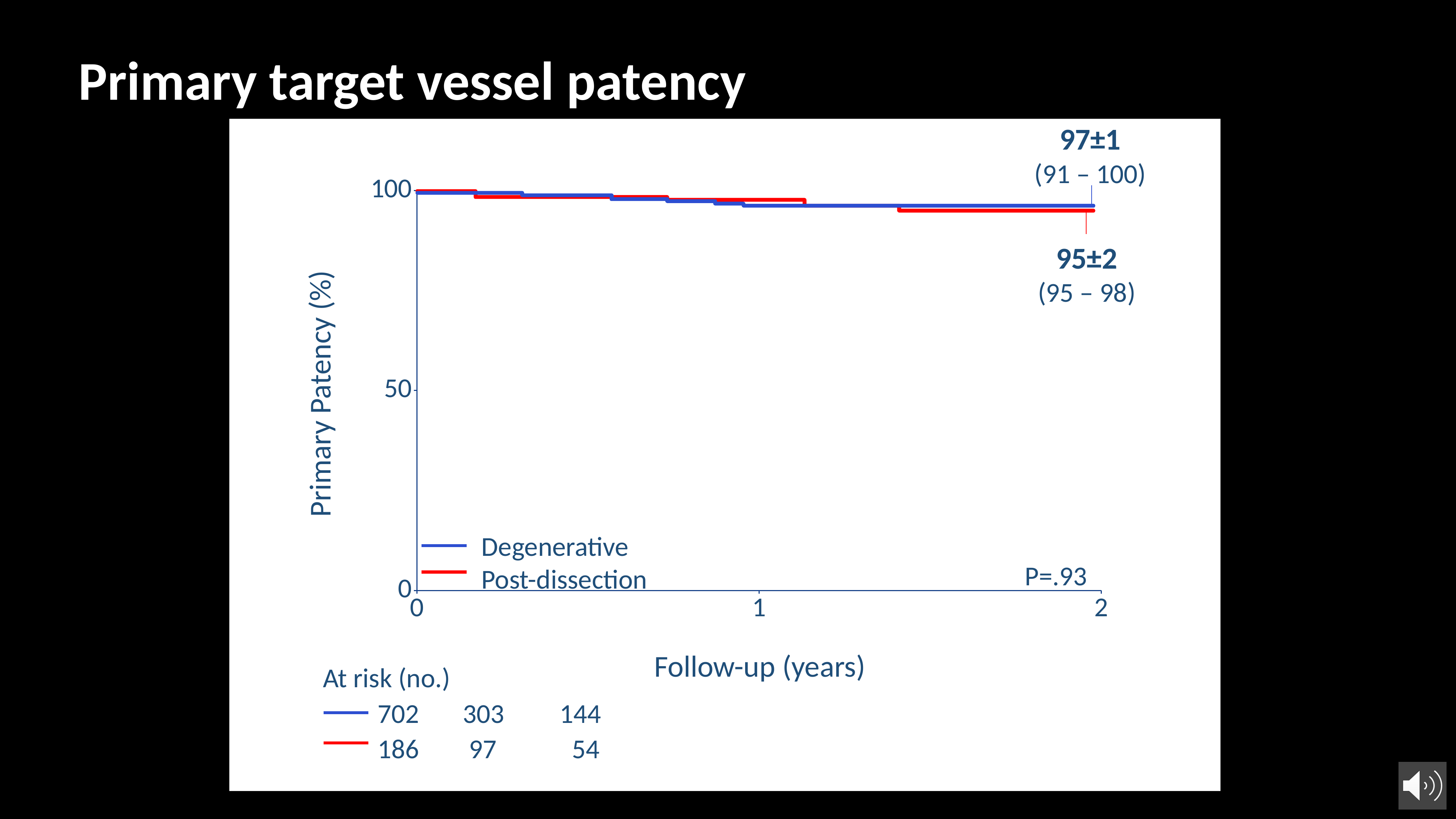
Which group has the higher primary patency at 2 years, Degenerative or Post-dissection? Degenerative What is the difference in the number at risk at 1 year between the Degenerative (303) and Post-dissection (97) groups? 206 What is the primary patency at 2 years for the Post-dissection group, as labelled on the chart? 95±2 How many Post-dissection patients were at risk at 2 years? 54 What is the primary patency at 2 years for the Degenerative group, as labelled on the chart? 97±1 How many Degenerative patients were at risk at 0 years? 702 What is the title of the chart on the slide? Primary target vessel patency Is the primary patency for the Post-dissection group at 2 years greater or less than 50? greater What is the P value shown on the chart? P=.93 How many series does the legend list? 2 Do the primary patency curves rise or fall over the follow-up period? Fall What kind of chart is shown on the slide? Line chart (Kaplan-Meier curve)